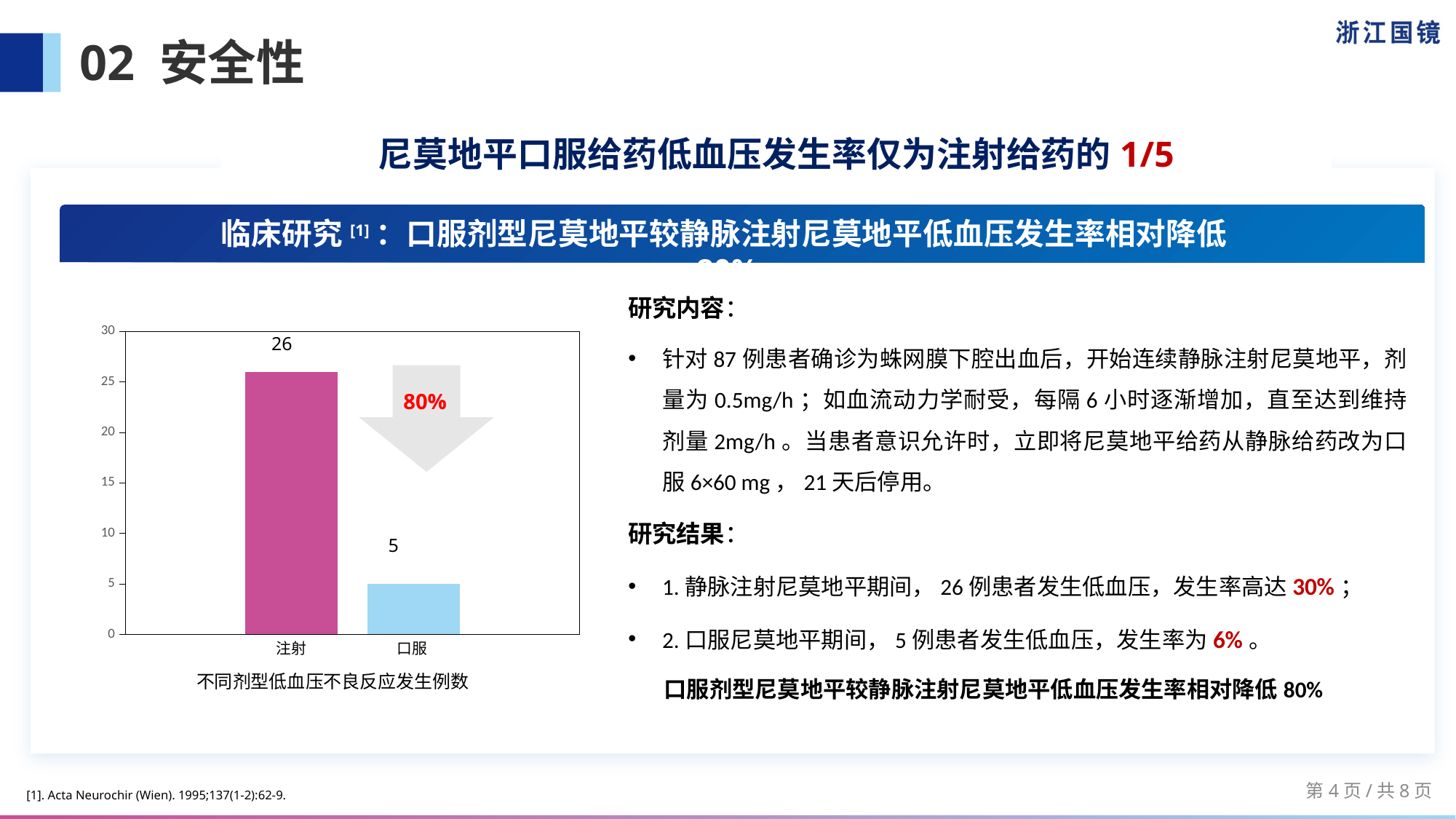
What percentage is printed on the arrow between the two bars? 80% Which category has the lowest value in the chart? 口服 What is the value for 口服 in the chart? 5 Which is larger, the value for 注射 or the value for 口服? 注射 Which category has the highest value in the chart? 注射 Is the value for 口服 greater or less than 10? less What is the difference between the values for 注射 and 口服? 21 Is the value for 注射 greater or less than 20? greater What is the value for 注射 in the chart? 26 What kind of chart is shown on the slide? bar chart What is the caption below the chart? 不同剂型低血压不良反应发生例数 How many categories are shown in the chart? 2